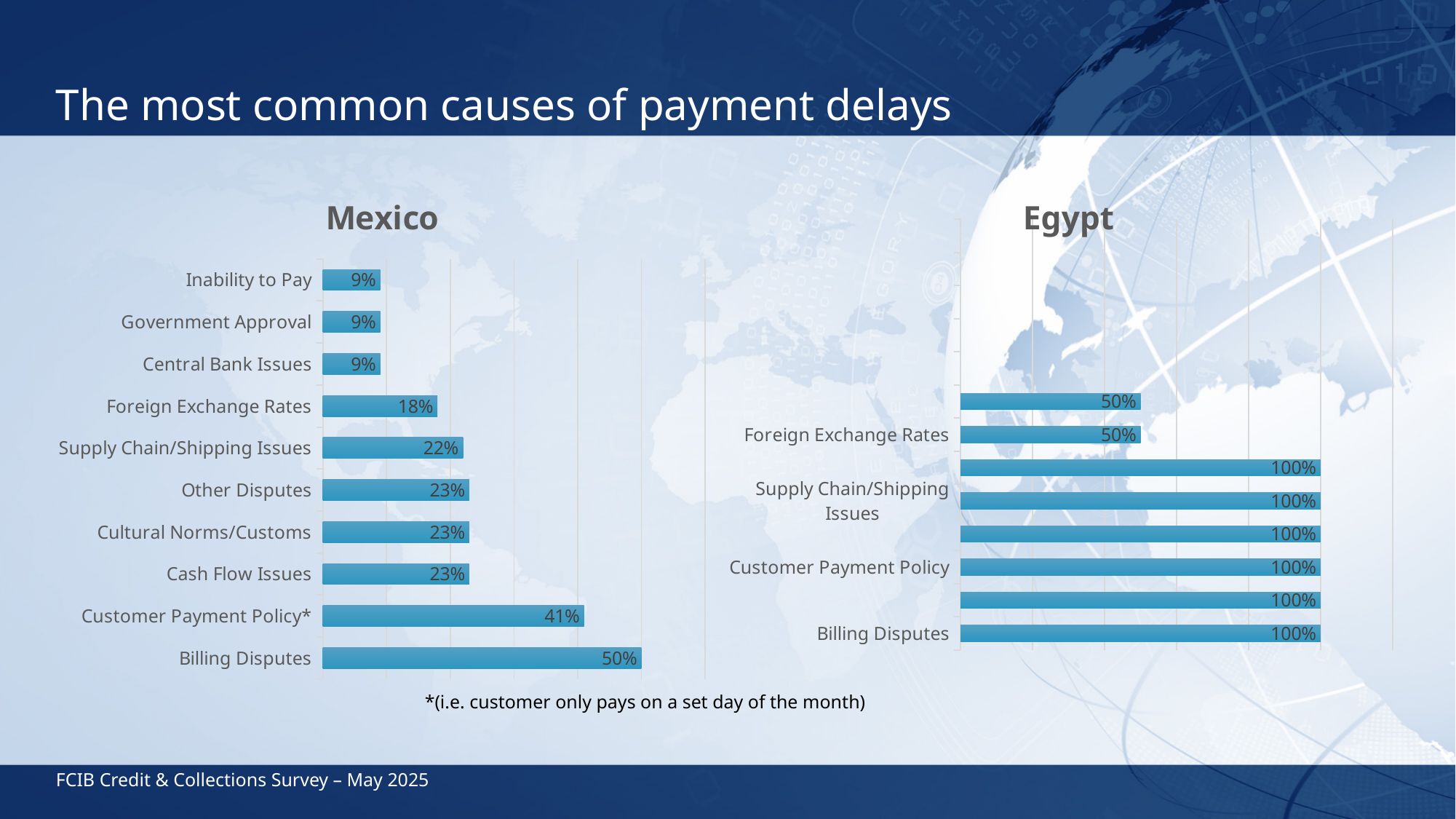
In the Egypt chart, what is the value for Billing Disputes? 100% In the Mexico chart, which is larger, Cash Flow Issues or Foreign Exchange Rates? Cash Flow Issues In the Mexico chart, what is the value for Customer Payment Policy*? 41% How many categories are shown in the Mexico chart? 10 In the Egypt chart, what is the value for Foreign Exchange Rates? 50% What type of chart is the Mexico chart? Bar chart In the Mexico chart, what is the value for Billing Disputes? 50% In the Mexico chart, what is the value for Supply Chain/Shipping Issues? 22% In the Mexico chart, which category has the highest value? Billing Disputes In the Egypt chart, what is the difference between Customer Payment Policy and Foreign Exchange Rates? 50% In the Mexico chart, what is the value for Foreign Exchange Rates? 18% In the Mexico chart, what is the difference between Billing Disputes and Customer Payment Policy*? 9%